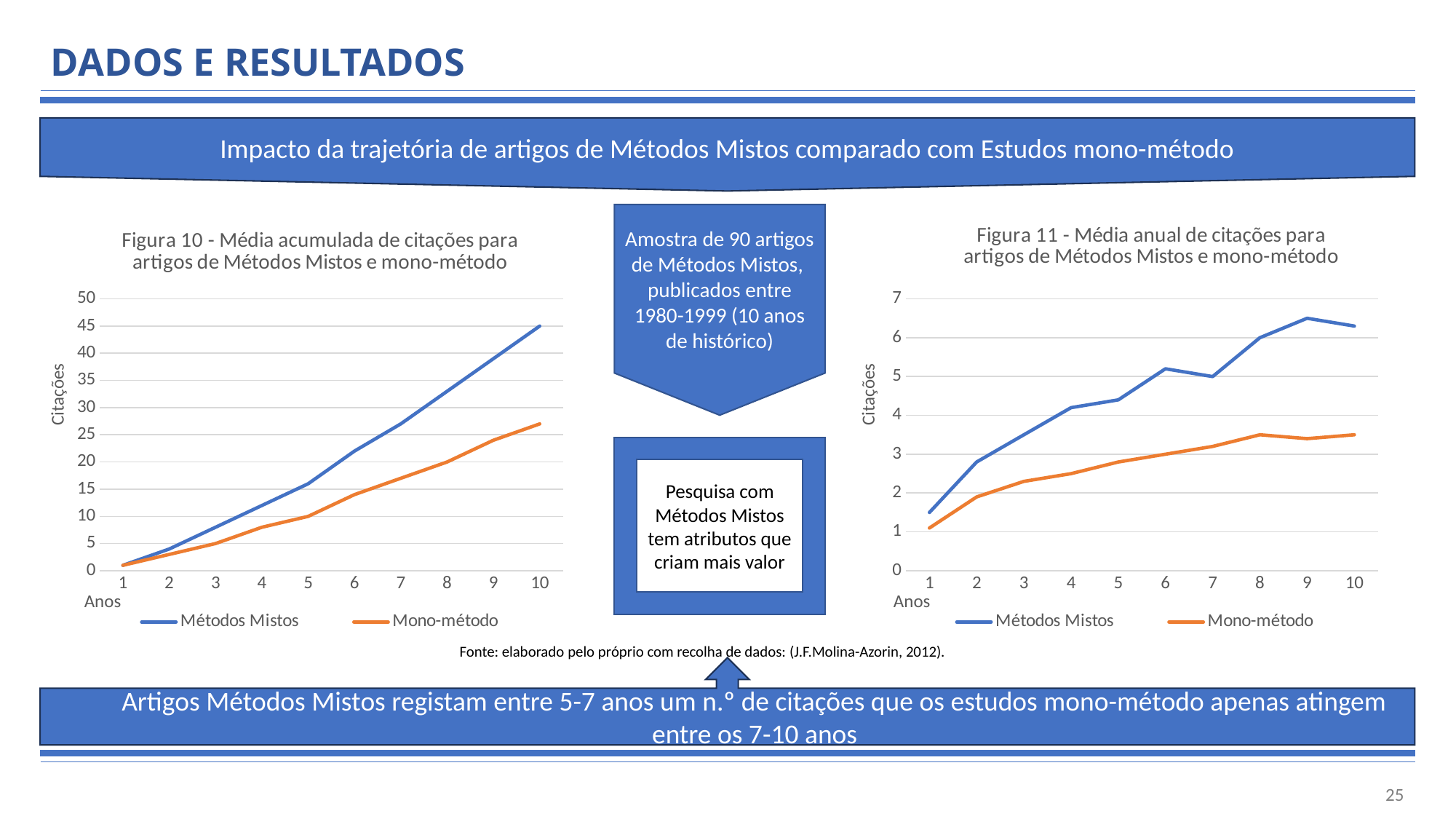
How many years are plotted on the x axis of Figura 10? 10 In Figura 10, which series is higher at year 8, Métodos Mistos or Mono-método? Métodos Mistos What is the y-axis label of Figura 11? Citações In Figura 10, do the values for Métodos Mistos rise or fall from year 1 to year 10? rise In Figura 11, is the value for Métodos Mistos at year 9 greater or less than 6? greater In Figura 10, what is the value for Mono-método at year 5? 10 How many series does the legend of Figura 11 list? 2 In Figura 10, what is the value for Métodos Mistos at year 10? 45 In Figura 11, which year has the highest value for Métodos Mistos? 9 What kind of chart is Figura 10? line chart In Figura 10, is the value for Mono-método at year 10 greater or less than 25? greater In Figura 11, is the value for Mono-método at year 10 greater or less than 4? less